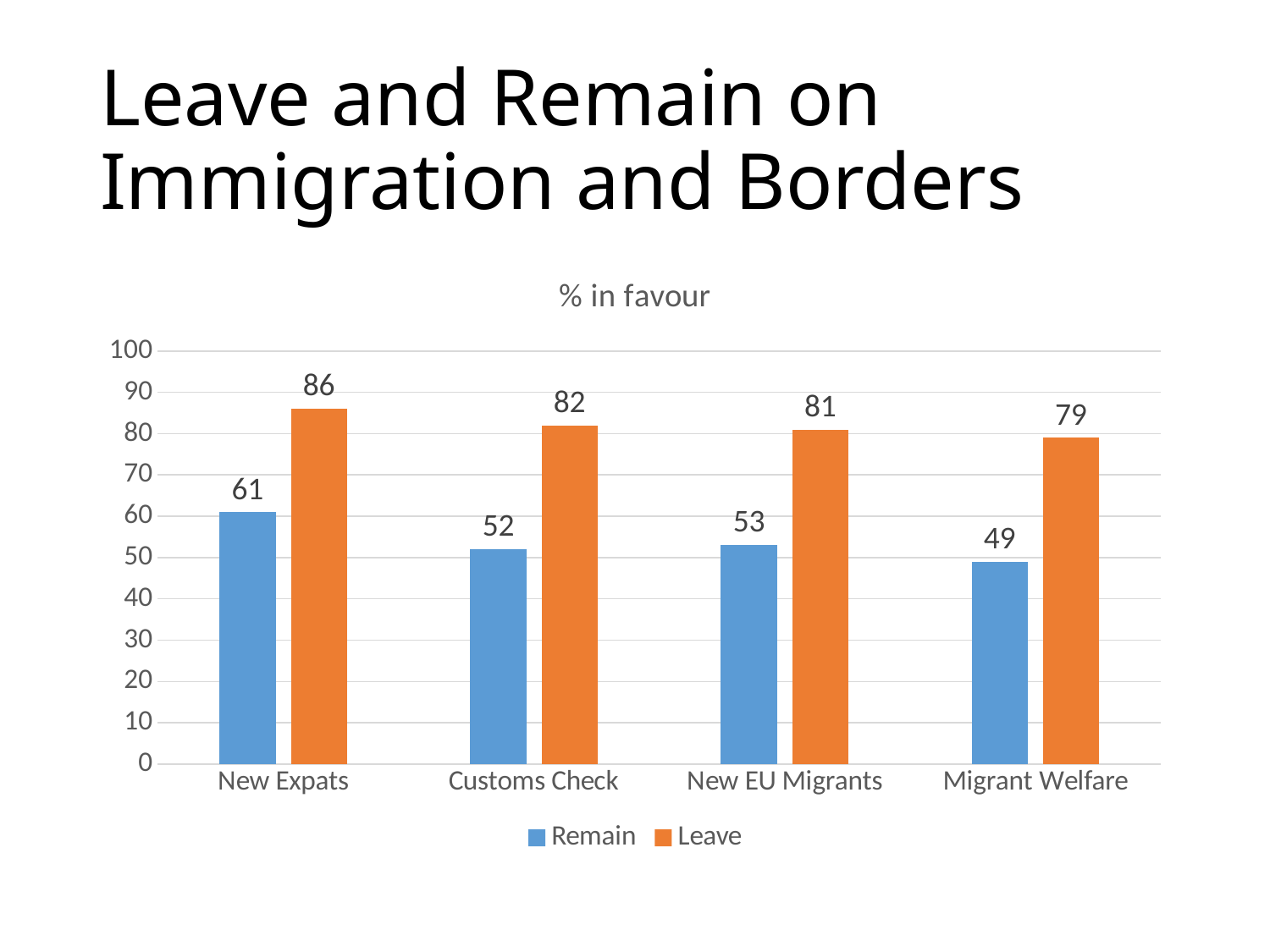
What is the Remain value for Migrant Welfare? 49 What kind of chart is shown on the slide? Bar chart Which is larger for Customs Check, the Remain value or the Leave value? Leave What is the difference between the Leave and Remain values for New EU Migrants? 28 Which category has the highest Leave value? New Expats What is the title of the chart? % in favour How many categories are shown on the x axis? 4 Is the Leave value for Migrant Welfare greater or less than 70? greater How many series does the legend list? 2 What is the Remain value for New Expats? 61 What is the Leave value for Customs Check? 82 Which category has the lowest Remain value? Migrant Welfare